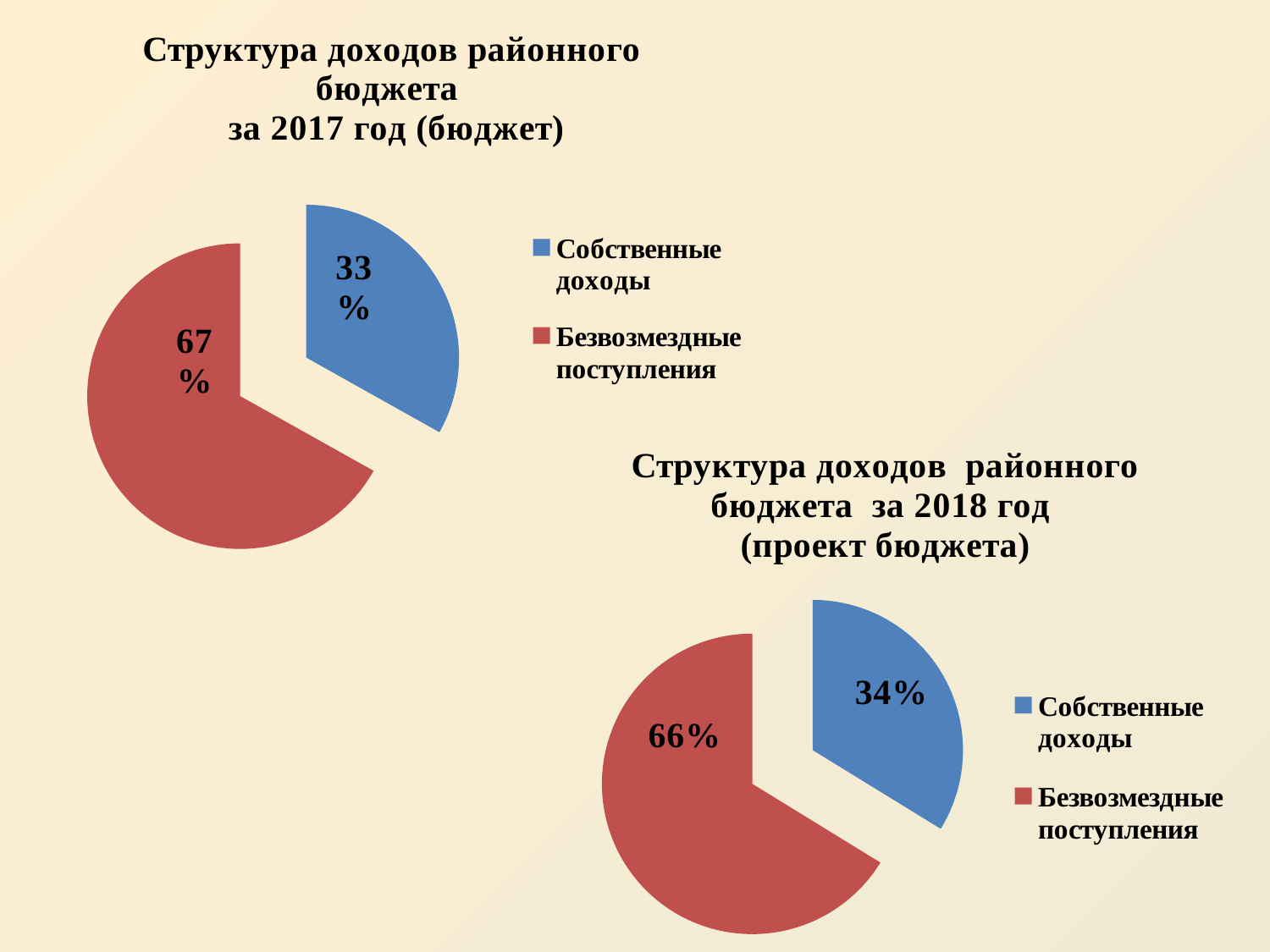
What type of chart is used for the 2017 budget structure (top left)? Pie chart In the 2017 chart (top left), what share of the pie is Собственные доходы? 33% In the 2018 chart (bottom right), what share of the pie is Собственные доходы? 34% In the 2018 chart (bottom right), which category has the smallest slice? Собственные доходы In the 2018 chart (bottom right), what share of the pie is Безвозмездные поступления? 66% In the 2017 chart (top left), which category has the largest slice? Безвозмездные поступления In the 2017 chart (top left), what is the difference between the shares of Безвозмездные поступления and Собственные доходы? 34% In the 2017 chart (top left), which colour represents Собственные доходы? Blue How many categories does the 2018 chart (bottom right) show? 2 Is the share of Собственные доходы larger in the 2017 chart or the 2018 chart? 2018 chart In the 2018 chart (bottom right), what is the difference between the shares of Безвозмездные поступления and Собственные доходы? 32%